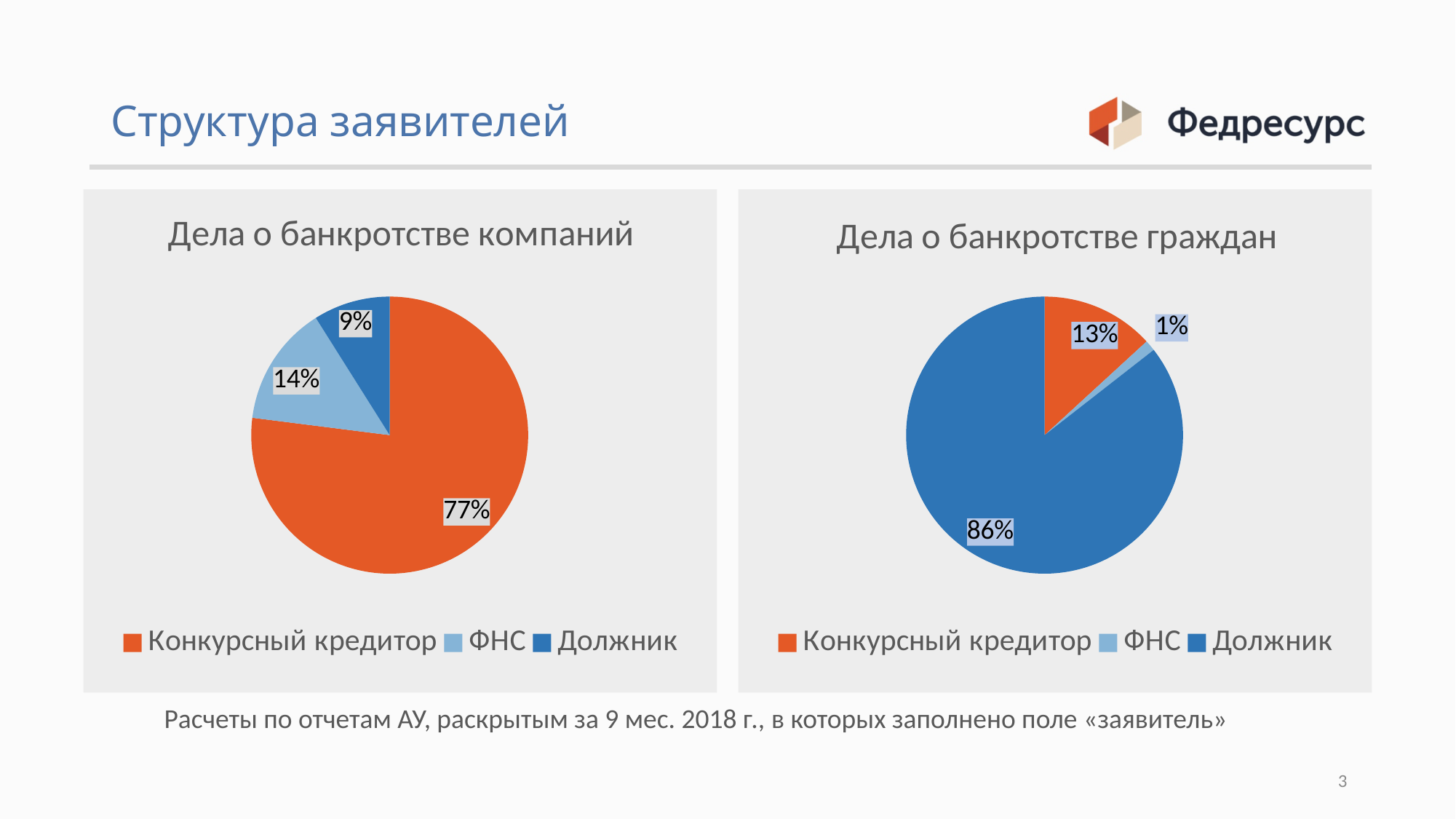
In the chart titled «Дела о банкротстве компаний», what is the difference between the «ФНС» share and the «Должник» share? 5% In the chart titled «Дела о банкротстве компаний», what share of the pie is «Должник»? 9% In the chart titled «Дела о банкротстве граждан», what share of the pie is «Конкурсный кредитор»? 13% In the chart titled «Дела о банкротстве граждан», what share of the pie is «Должник»? 86% In the chart titled «Дела о банкротстве граждан», which category has the smallest slice? ФНС In the chart titled «Дела о банкротстве компаний», which category has the largest slice? Конкурсный кредитор Which is larger in the chart titled «Дела о банкротстве граждан»: the «Должник» share or the «Конкурсный кредитор» share? Должник What type of chart is shown on the left side of the slide? Pie chart How many entries does the legend of the chart titled «Дела о банкротстве граждан» list? 3